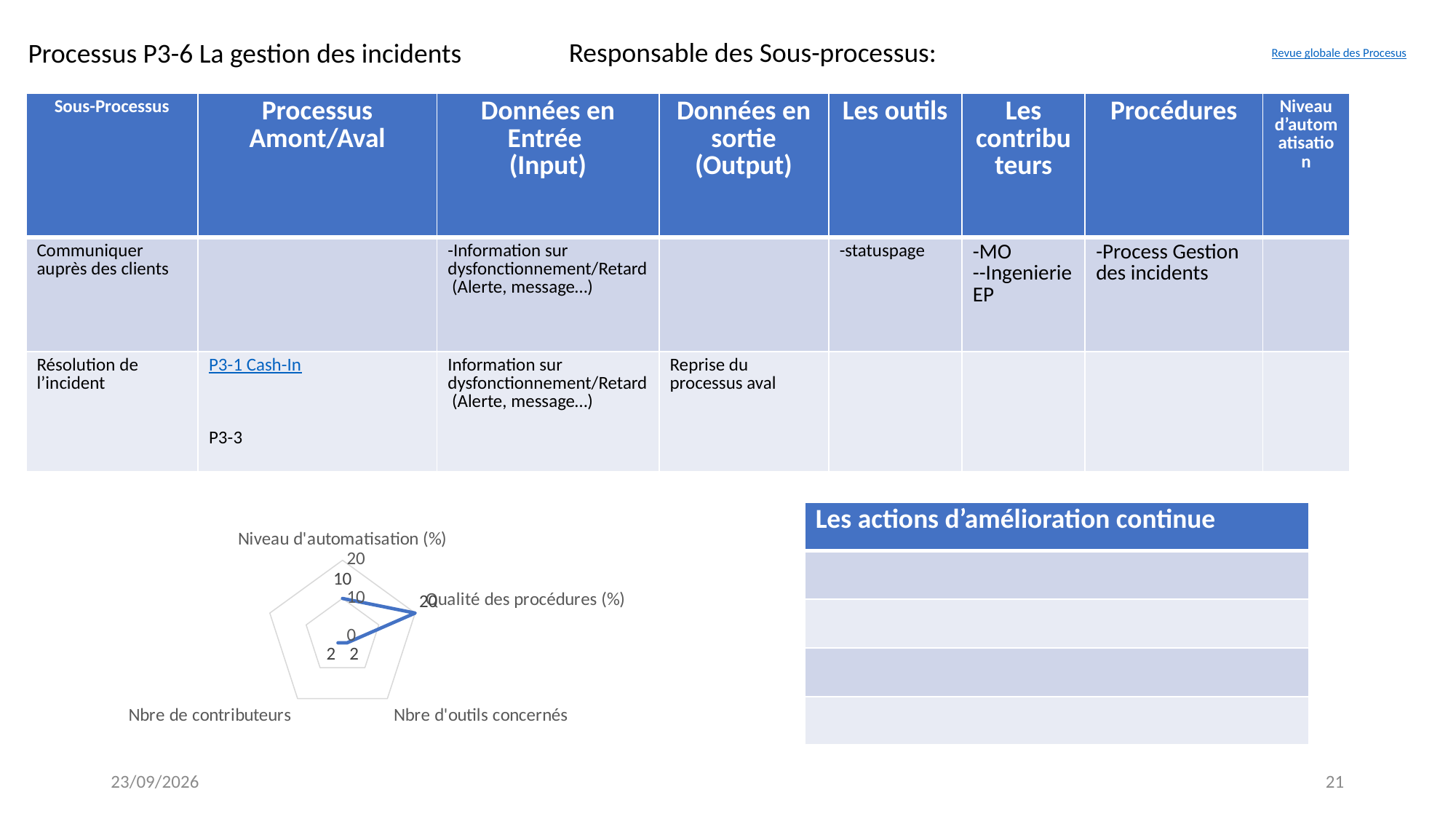
What colour is the data line plotted on the radar chart? Blue How many axes does the radar chart have? 5 What kind of chart is shown at the bottom left of the slide? Radar chart In the radar chart, which is larger: the value for Niveau d'automatisation (%) or the value for Qualité des procédures (%)? Qualité des procédures (%) In the radar chart, which labelled axis has the highest value? Qualité des procédures (%) What is the highest tick value shown on the radar chart's scale? 20 In the radar chart, what is the value for Niveau d'automatisation (%)? 10 In the radar chart, what is the value for Nbre d'outils concernés? 2 In the radar chart, what is the difference between the value for Qualité des procédures (%) and the value for Niveau d'automatisation (%)? 10 In the radar chart, is the value for Qualité des procédures (%) greater or less than 10? greater In the radar chart, what is the value for Qualité des procédures (%)? 20 In the radar chart, what is the value for Nbre de contributeurs? 2